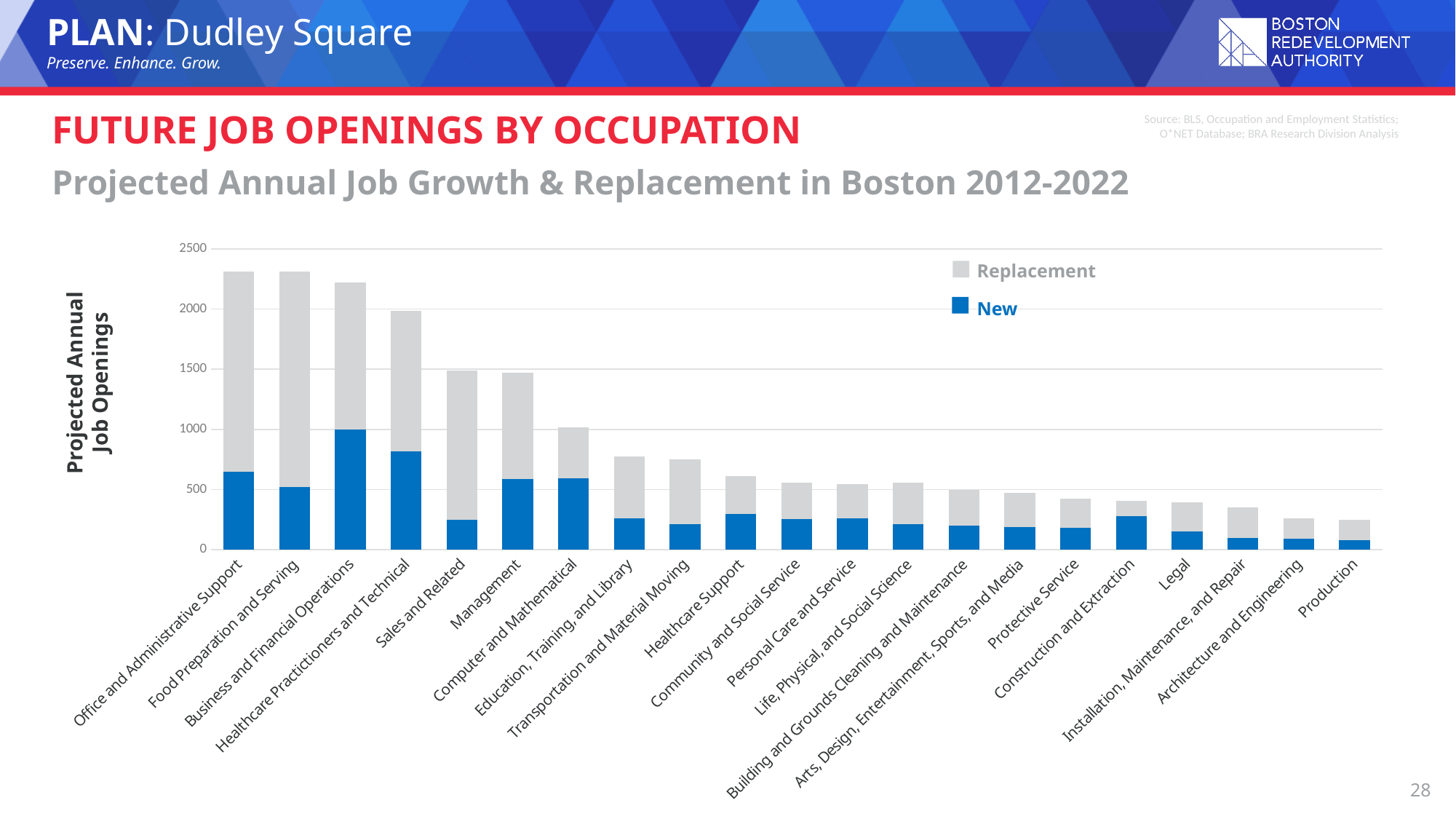
Do the total bar heights rise or fall moving from left to right along the x axis? fall Which colour represents the Replacement series in the legend? grey Is the total value for Business and Financial Operations greater or less than 2000? greater How many occupation categories are shown on the x axis? 21 How many series does the legend list? 2 What kind of chart is shown on the slide? stacked bar chart Is the New value for Sales and Related greater or less than 500? less Which occupation has the highest value for New job openings? Business and Financial Operations Which has the larger total: Sales and Related or Education, Training, and Library? Sales and Related Is the total value for Legal greater or less than 500? less Which has the larger New value: Healthcare Practitioners and Technical or Management? Healthcare Practitioners and Technical